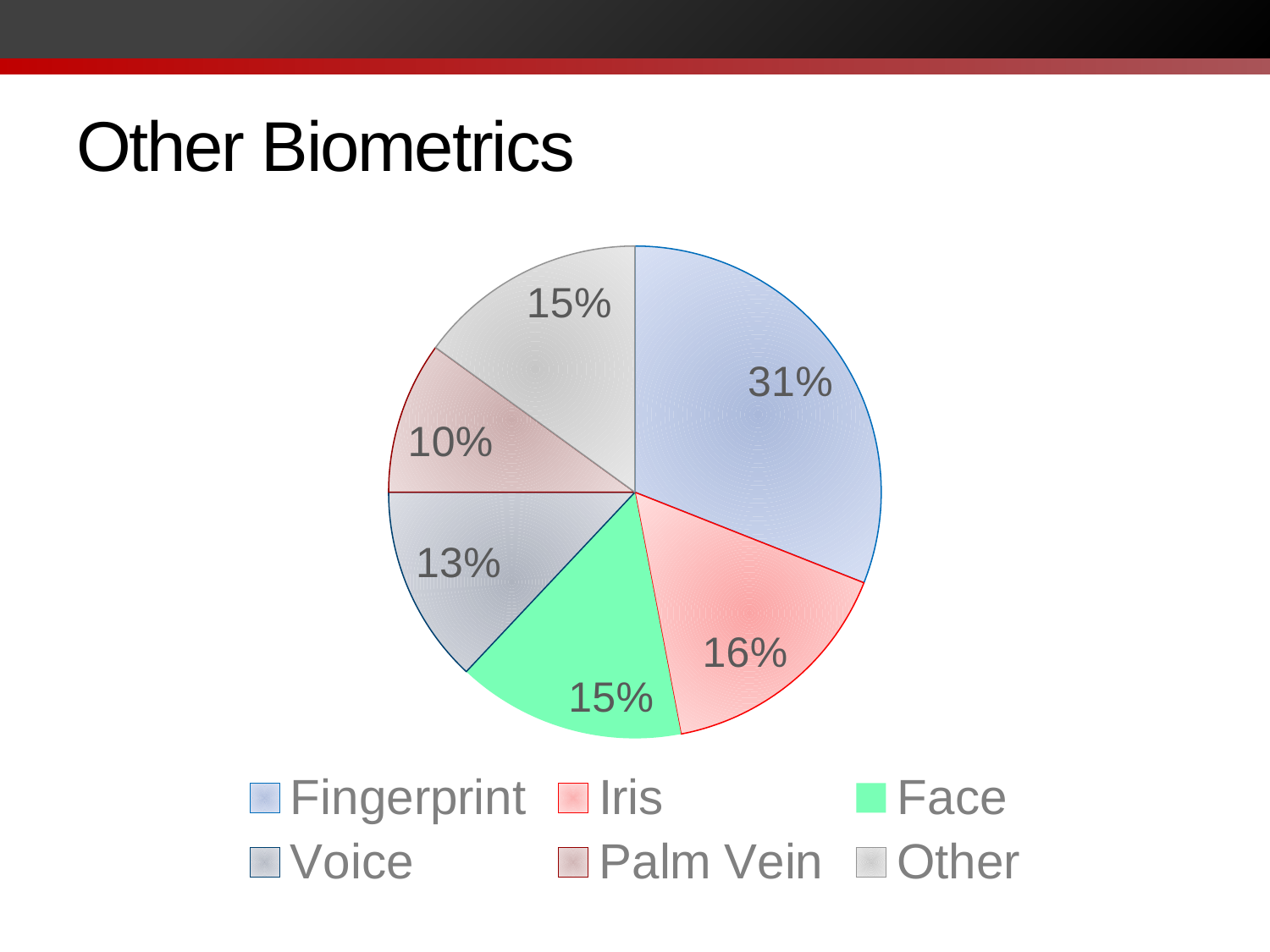
What is the title of the slide containing the chart? Other Biometrics What is the difference in percentage points between Fingerprint and Iris? 15 What share of the pie does Palm Vein have? 10% Which is larger, the Voice slice or the Iris slice? Iris What share of the pie does Voice have? 13% What kind of chart is shown on the slide? Pie chart Which category has the largest slice of the pie? Fingerprint How many categories are shown in the pie chart? 6 What share of the pie does Fingerprint have? 31% Which category has the smallest slice of the pie? Palm Vein What share of the pie does Face have? 15% What share of the pie does Iris have? 16%